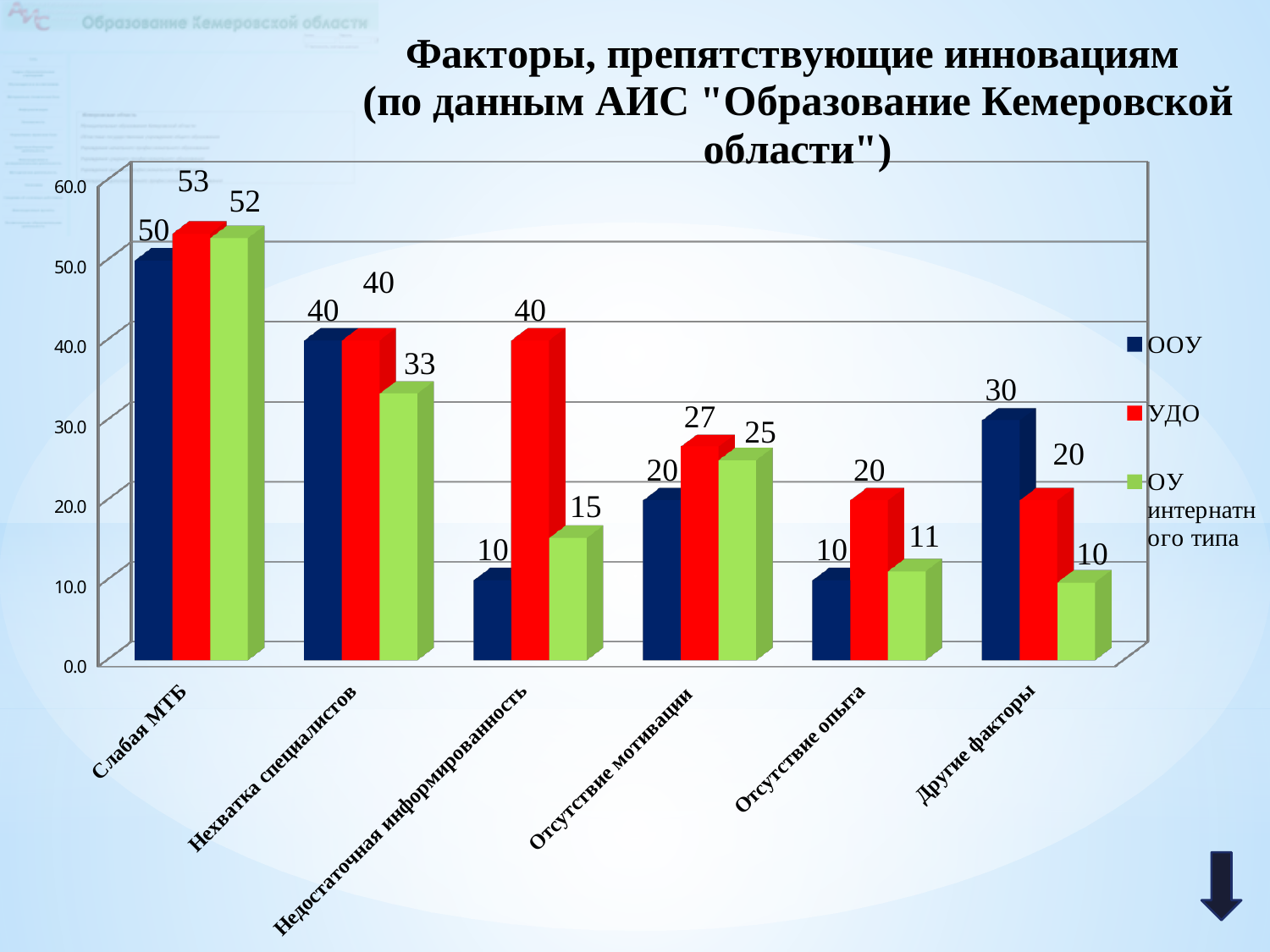
Is the value for УДО in the category Отсутствие опыта greater or less than 10? greater Which colour represents the УДО series in the chart? red Which category has the lowest value for the ОУ интернатного типа series? Другие факторы How many categories are shown on the x axis? 6 How many series does the legend list? 3 Which category has the highest value for the УДО series? Слабая МТБ What is the value for УДО in the category Недостаточная информированность? 40 What is the value for ООУ in the category Слабая МТБ? 50 What is the difference between the УДО and ООУ values in the category Недостаточная информированность? 30 What is the value for ОУ интернатного типа in the category Отсутствие мотивации? 25 What kind of chart is shown on the slide? bar chart In the category Другие факторы, which series has the larger value, ООУ or УДО? ООУ